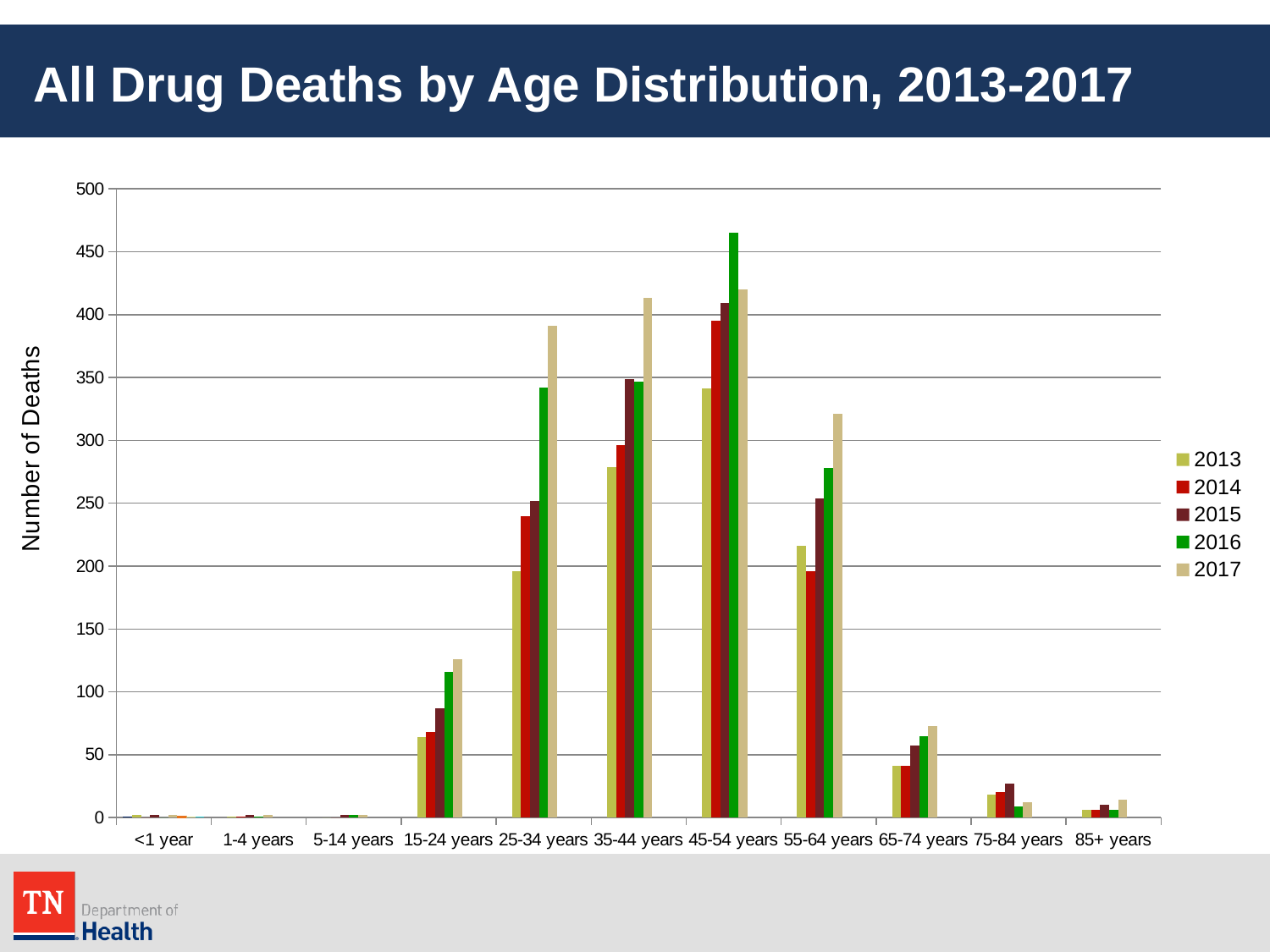
What kind of chart is shown on the slide? bar chart Is the 2013 value for 15-24 years greater or less than 100? less Which age group has the highest value for 2016? 45-54 years For 55-64 years, which is larger: the 2013 value or the 2017 value? 2017 Is the 2017 value for 55-64 years greater or less than 300? greater For 45-54 years, which is larger: the 2016 value or the 2017 value? 2016 Is the 2017 value for 25-34 years greater or less than 350? greater Which year has the lowest value for 25-34 years? 2013 What is the label of the y axis? Number of Deaths How many series does the legend list? 5 How many age groups are shown on the x axis? 11